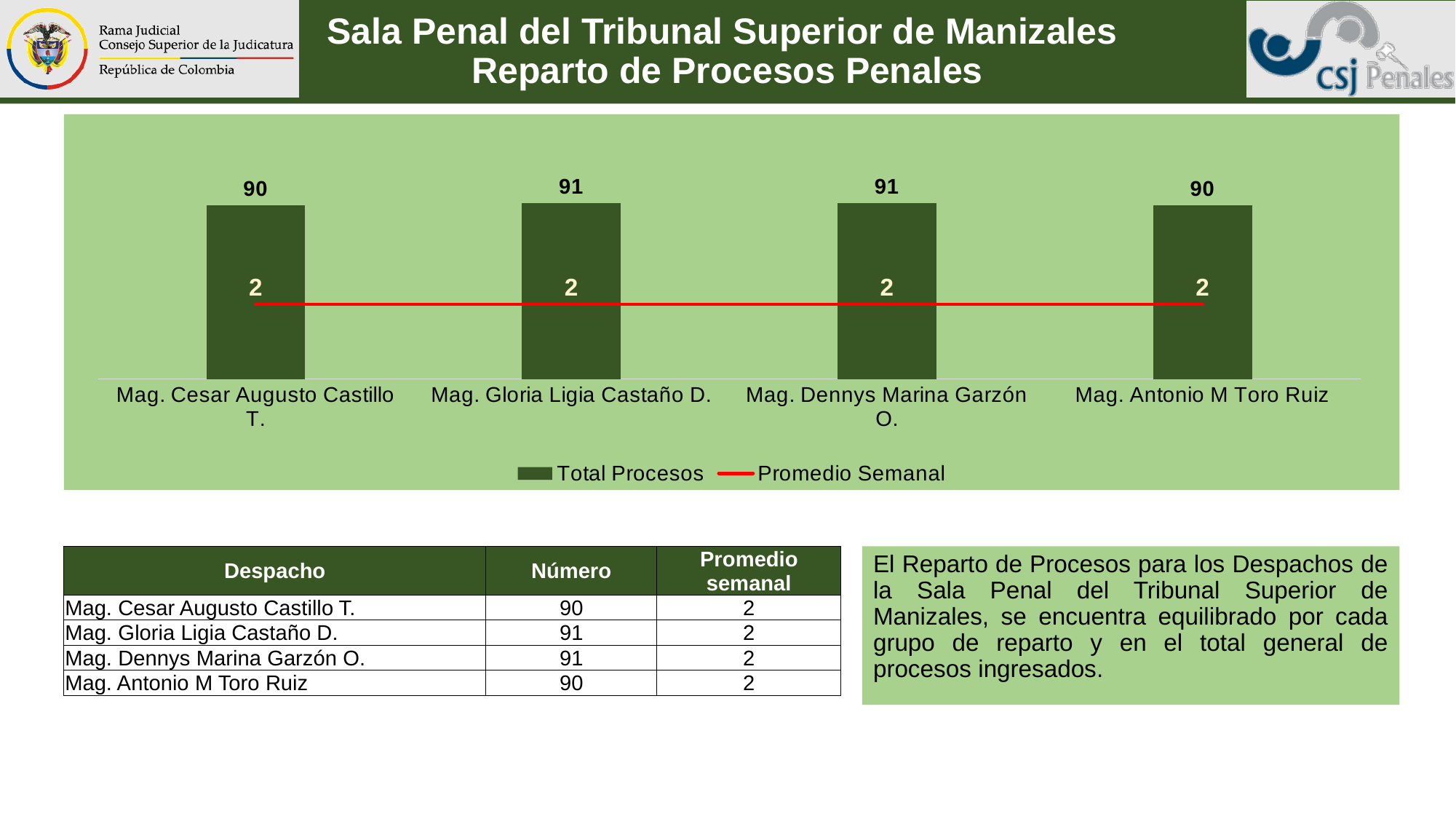
How many series does the chart legend list? 2 What is the Total Procesos value for Mag. Antonio M Toro Ruiz? 90 What is the Total Procesos value for Mag. Dennys Marina Garzón O.? 91 What kind of chart is shown on the slide? Bar chart with a line series Which has a larger Total Procesos value, Mag. Dennys Marina Garzón O. or Mag. Antonio M Toro Ruiz? Mag. Dennys Marina Garzón O. What is the Total Procesos value for Mag. Cesar Augusto Castillo T.? 90 Does the Promedio Semanal line rise, fall, or stay flat across the categories? Stays flat What is the Promedio Semanal value for Mag. Antonio M Toro Ruiz? 2 How many categories (despachos) are shown on the x axis of the chart? 4 What is the Total Procesos value for Mag. Gloria Ligia Castaño D.? 91 Which series in the legend is drawn as a red line? Promedio Semanal What is the difference between the Total Procesos values for Mag. Gloria Ligia Castaño D. and Mag. Cesar Augusto Castillo T.? 1